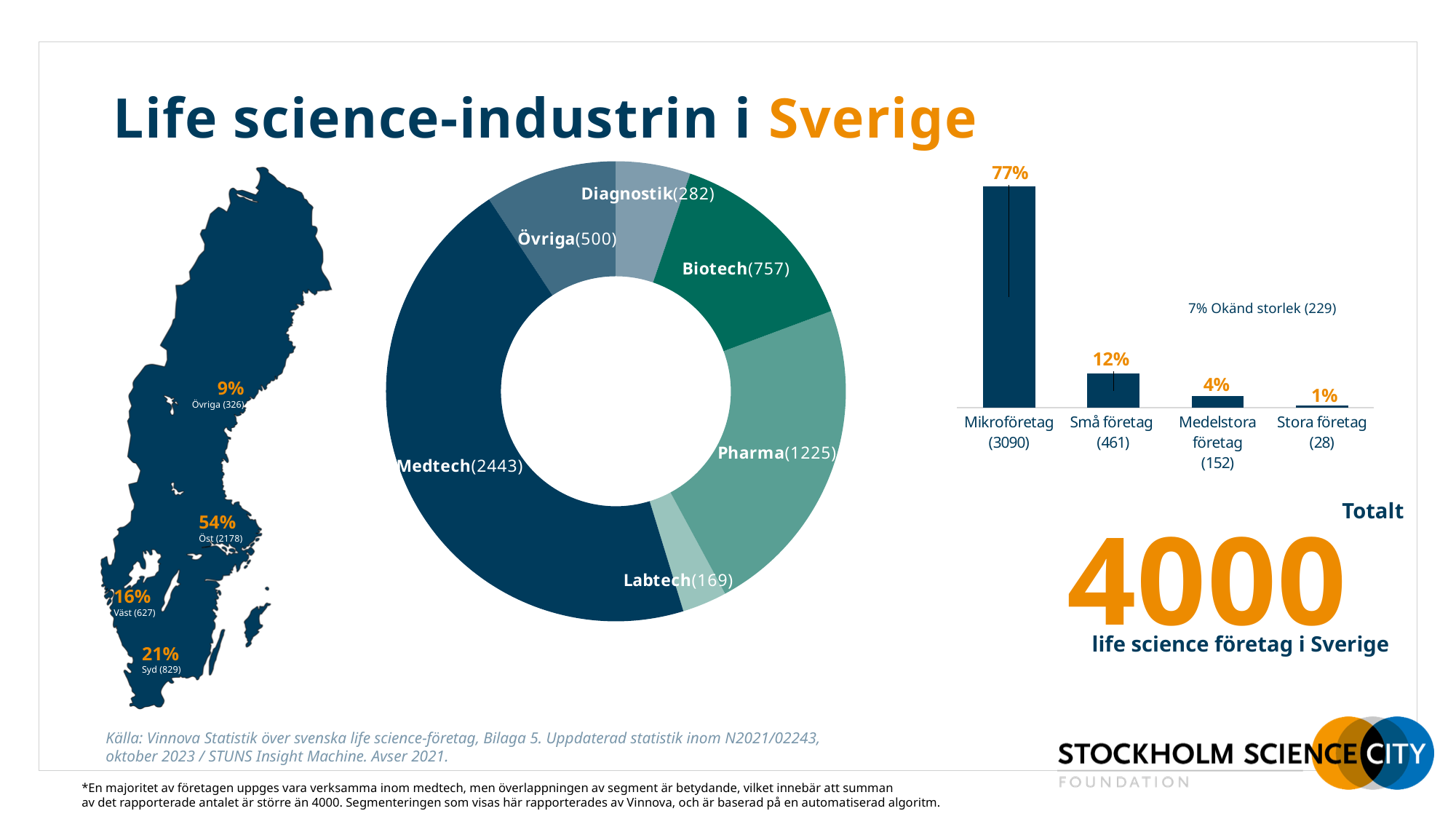
In the donut chart, which segment has the smallest number of companies? Labtech In the donut chart, which is larger, Biotech or Övriga? Biotech In the donut chart, how many companies are in the Pharma segment? 1225 What is the difference between the Medtech and Pharma values in the donut chart? 1218 How many bars does the bar chart on the right have? 4 In the donut chart, which segment has the largest number of companies? Medtech What kind of chart is the chart in the middle of the slide? Donut (pie) chart In the bar chart on the right, what percentage is shown for Mikroföretag? 77% In the bar chart on the right, which category has the lowest percentage? Stora företag In the bar chart on the right, what is the difference in percentage points between Mikroföretag and Små företag? 65 percentage points In the bar chart on the right, how many companies are Små företag? 461 How many segments does the donut chart show? 6